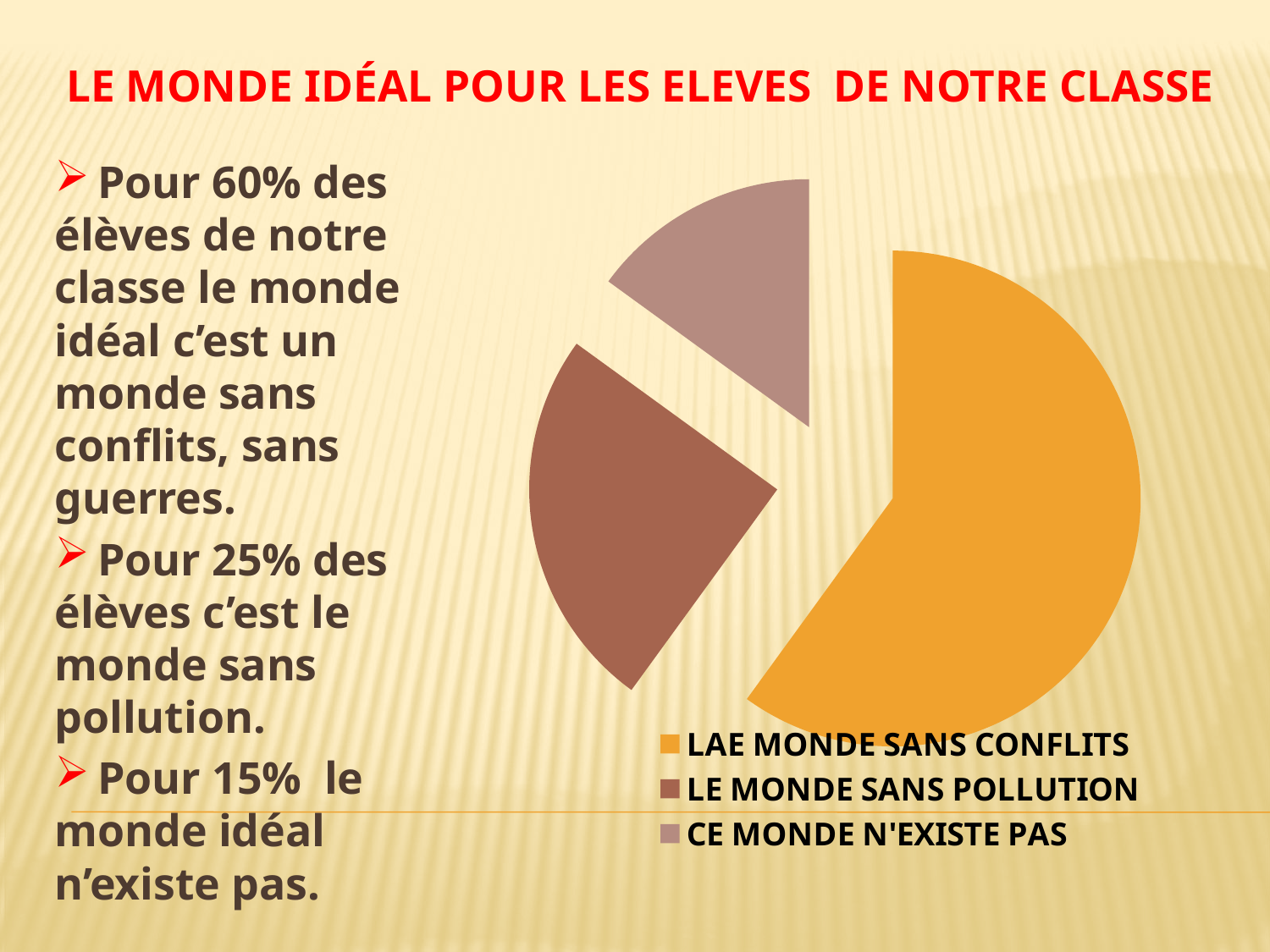
Which slice is larger: LE MONDE SANS POLLUTION or CE MONDE N'EXISTE PAS? LE MONDE SANS POLLUTION According to the slide, what share of the pupils chose a world without conflicts (LAE MONDE SANS CONFLITS)? 60% Which category has the smallest slice in the pie chart? CE MONDE N'EXISTE PAS How many entries does the legend of the pie chart list? 3 According to the slide, what share of the pupils think the ideal world does not exist (CE MONDE N'EXISTE PAS)? 15% What kind of chart is shown on the slide? pie chart What is the title of the slide containing the pie chart? LE MONDE IDÉAL POUR LES ELEVES DE NOTRE CLASSE What colour is the slice for LE MONDE SANS POLLUTION in the pie chart? brown Which category has the largest slice in the pie chart? LAE MONDE SANS CONFLITS What is the difference in percentage points between the share for LAE MONDE SANS CONFLITS and the share for LE MONDE SANS POLLUTION? 35 According to the slide, what share of the pupils chose a world without pollution (LE MONDE SANS POLLUTION)? 25% How many slices does the pie chart have? 3